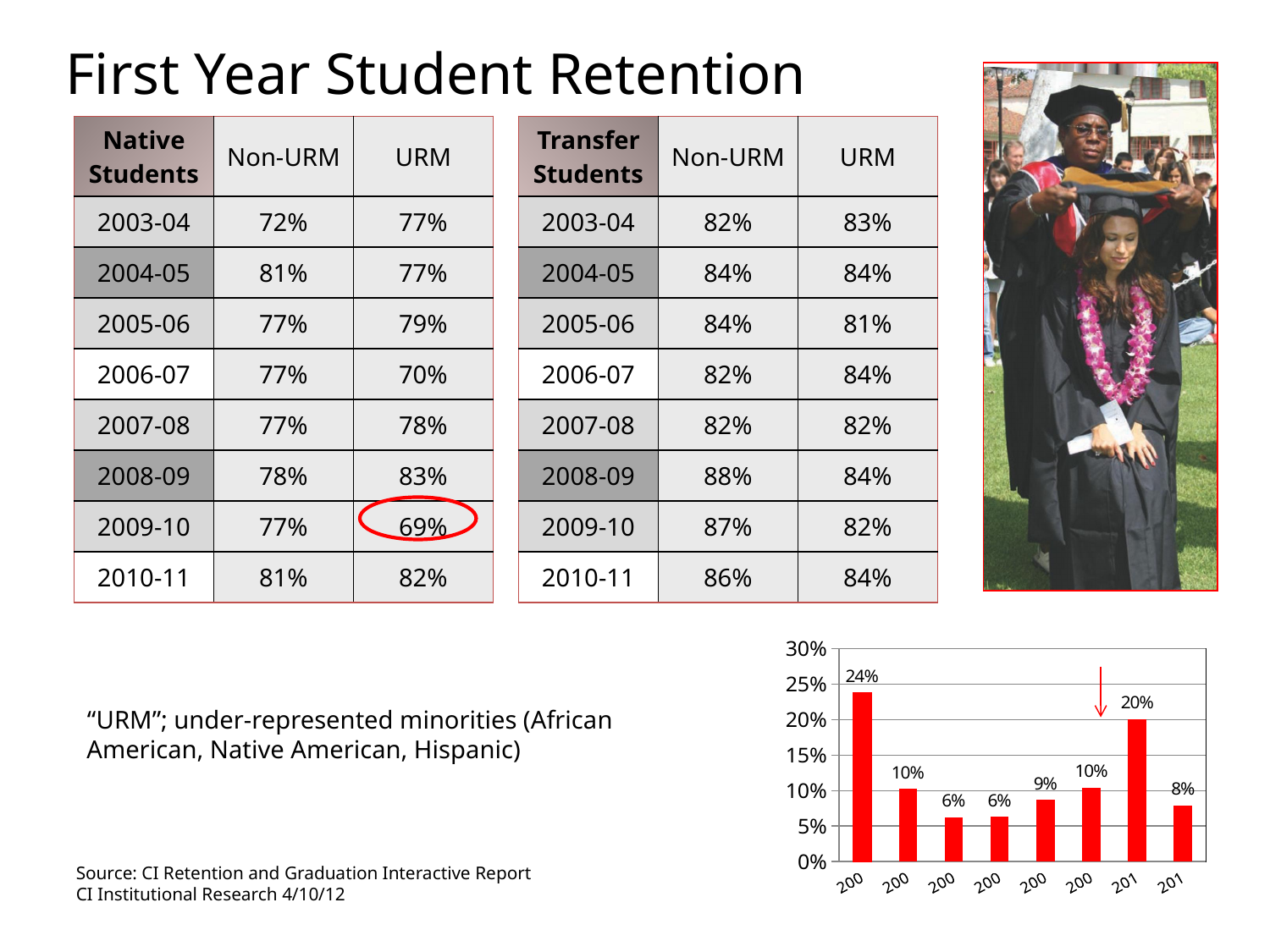
In the bar chart at the bottom right, which is larger: the first bar or the seventh bar? the first bar In the bar chart at the bottom right, is the value of the seventh bar greater or less than 15%? greater In the bar chart at the bottom right, what is the value of the seventh bar, the one the red arrow points to? 20% In the bar chart at the bottom right, what is the lowest value shown? 6% In the bar chart at the bottom right, what is the value of the last (rightmost) bar? 8% In the bar chart at the bottom right, what is the value of the fifth bar? 9% What colour are the bars in the bar chart at the bottom right of the slide? red What kind of chart is shown at the bottom right of the slide? bar chart How many bars does the bar chart at the bottom right of the slide have? 8 In the bar chart at the bottom right, what is the difference between the first bar and the last bar? 16 percentage points In the bar chart at the bottom right, what is the value of the first (leftmost) bar? 24% In the bar chart at the bottom right, what is the highest value shown? 24%